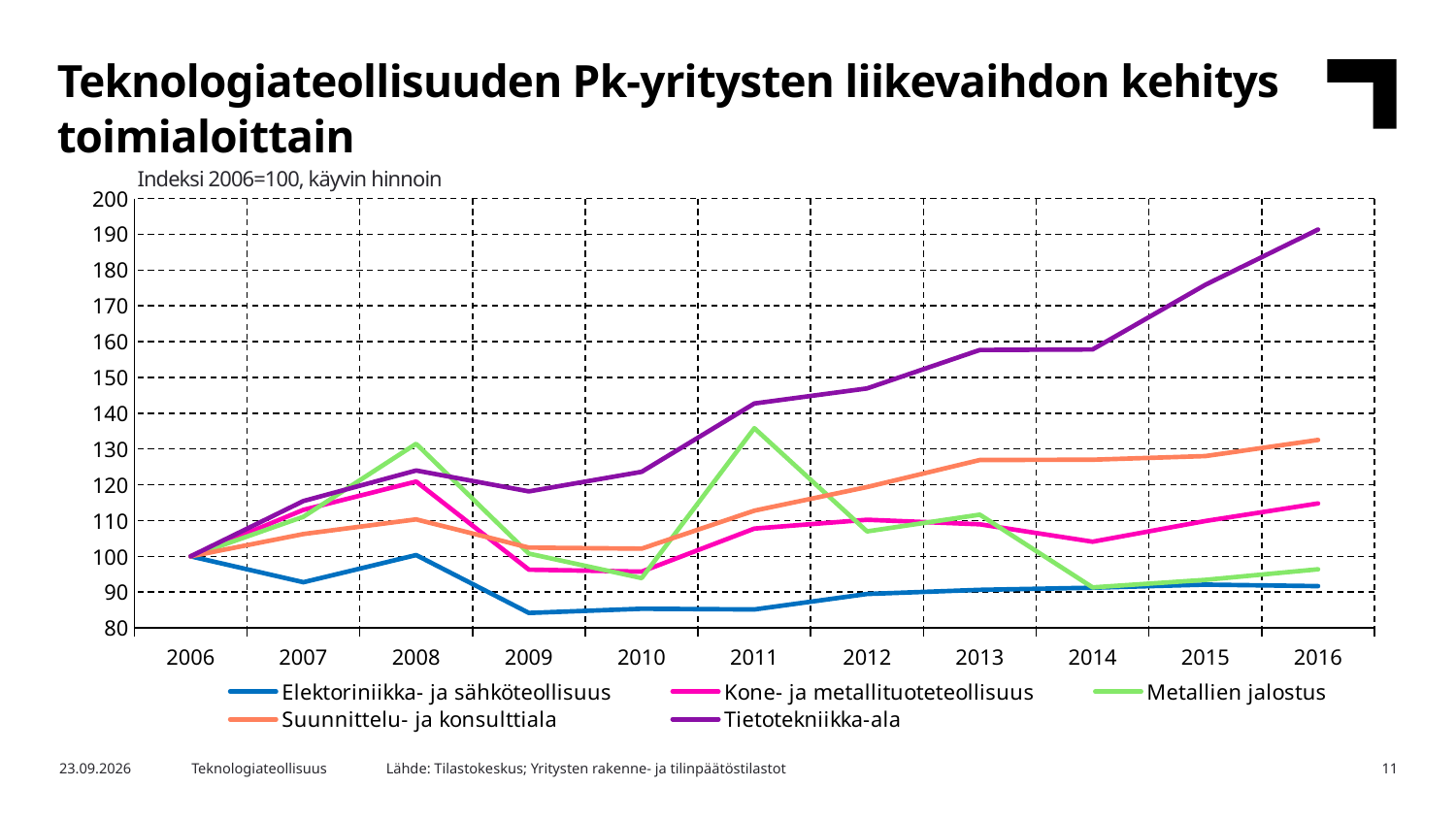
What index base is stated in the chart subtitle? Indeksi 2006=100, käyvin hinnoin What kind of chart is shown on the slide? line chart What is the value of Tietotekniikka-ala in 2006? 100 How many series does the legend list? 5 Is the value for Metallien jalostus in 2011 greater or less than 130? greater Does the Tietotekniikka-ala line rise or fall overall from 2006 to 2016? rise Is the value for Tietotekniikka-ala in 2016 greater or less than 180? greater Which series has the lowest value in 2016? Elektoriniikka- ja sähköteollisuus How many years are shown on the x axis? 11 In 2013, which is larger: Tietotekniikka-ala or Suunnittelu- ja konsulttiala? Tietotekniikka-ala Which series has the highest value in 2016? Tietotekniikka-ala Is the value for Elektoriniikka- ja sähköteollisuus in 2009 greater or less than 90? less